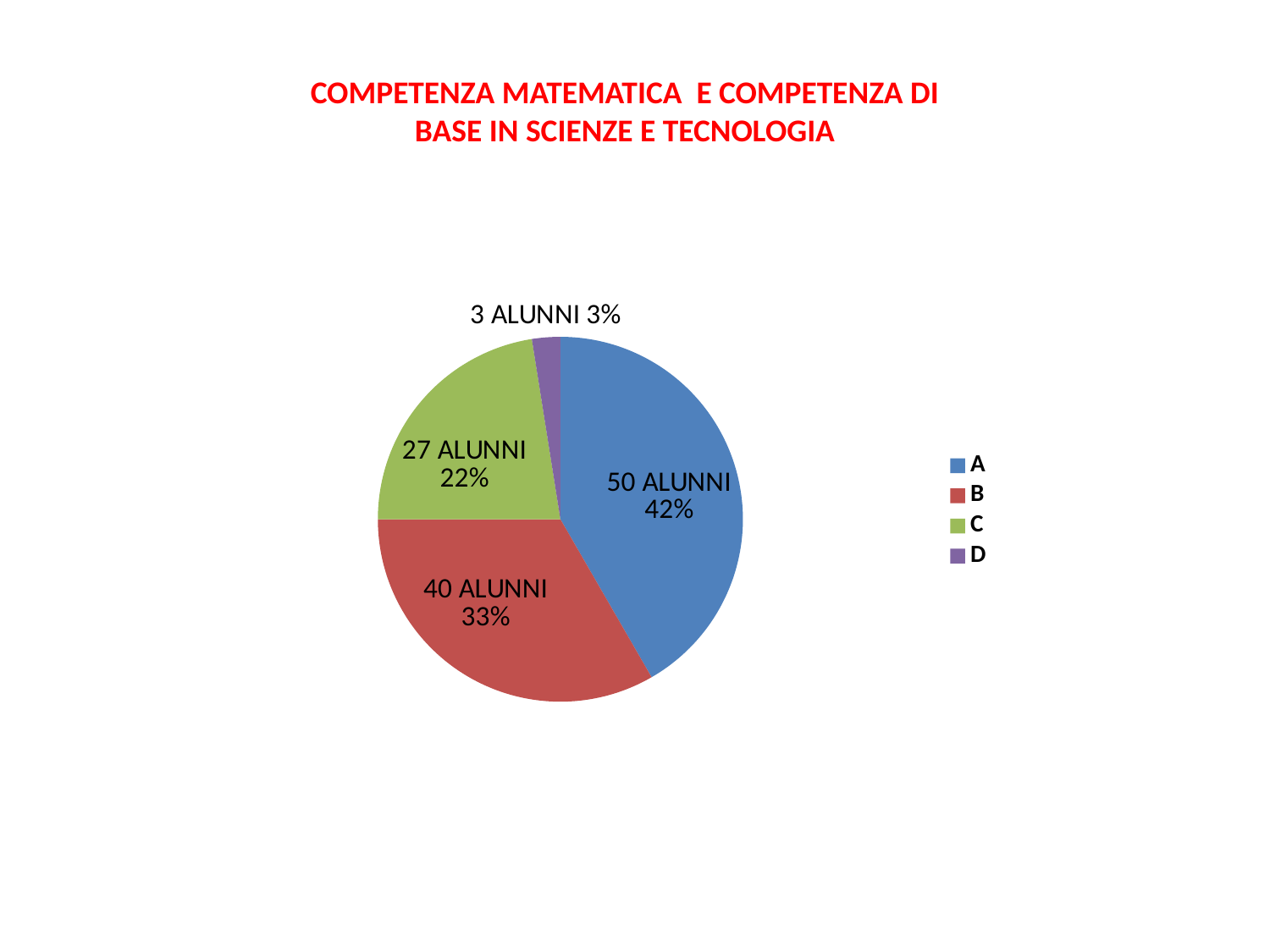
Which category has the smallest slice? D What kind of chart is shown on the slide? pie chart Which category has the largest slice? A How many alunni are in category B? 40 ALUNNI What is the difference in number of alunni between category A and category C? 23 What percentage share does slice D have? 3% What percentage share does slice A have? 42% How many slices does the pie chart have? 4 What is the title of the chart? COMPETENZA MATEMATICA E COMPETENZA DI BASE IN SCIENZE E TECNOLOGIA What percentage share does slice B have? 33% How many entries does the legend list? 4